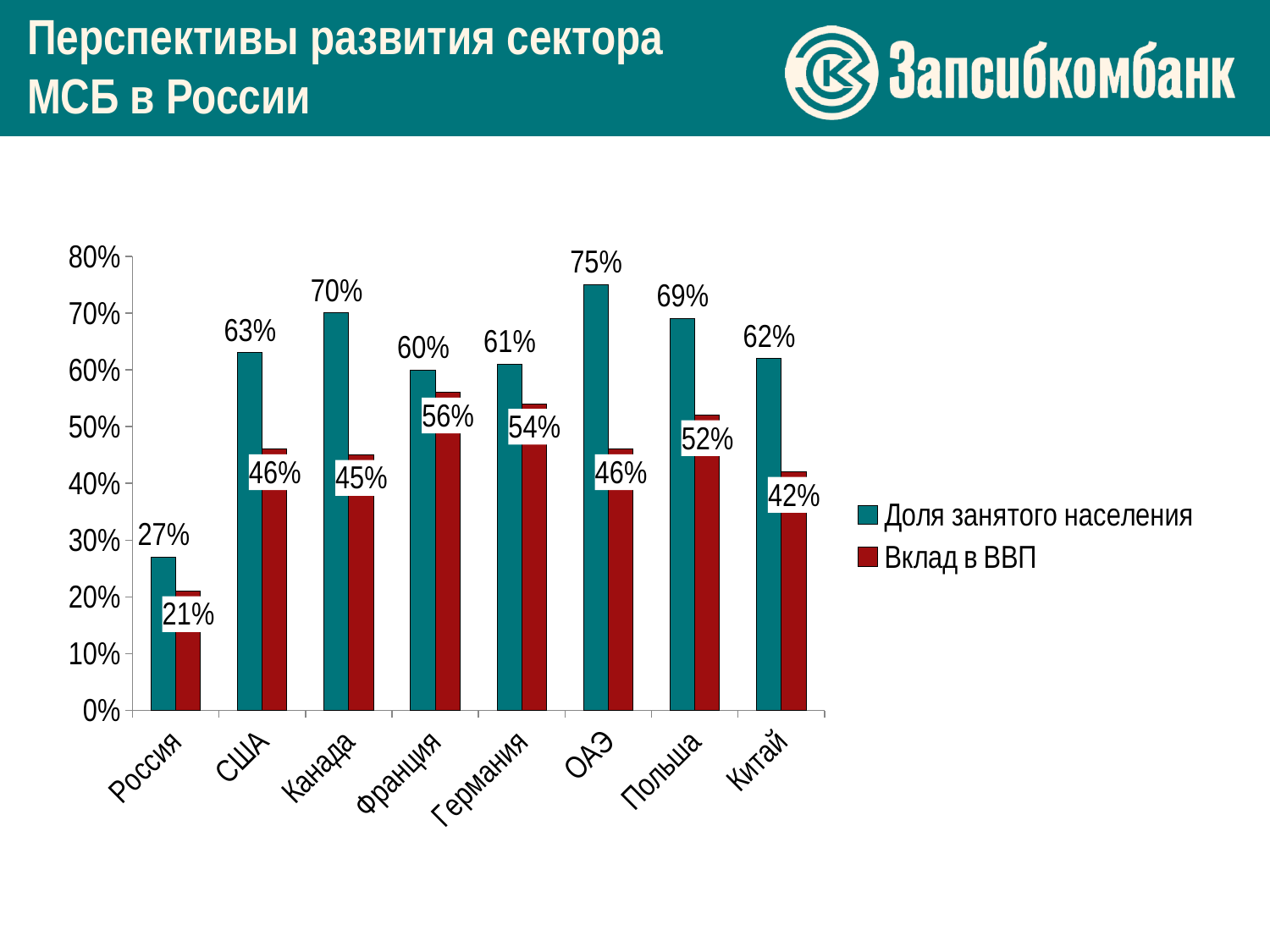
What is the value of "Доля занятого населения" for Россия? 27% What is the second series listed in the legend? Вклад в ВВП What is the difference between "Доля занятого населения" and "Вклад в ВВП" for Китай? 20% What kind of chart is shown on the slide? Bar chart Which country has the lowest value for "Вклад в ВВП"? Россия What is the value of "Доля занятого населения" for ОАЭ? 75% Which is larger: "Вклад в ВВП" for Германия or for Польша? Германия How many countries are shown on the x axis? 8 How many series does the legend list? 2 What is the value of "Вклад в ВВП" for Франция? 56% What is the value of "Вклад в ВВП" for Канада? 45% Which country has the highest value for "Доля занятого населения"? ОАЭ